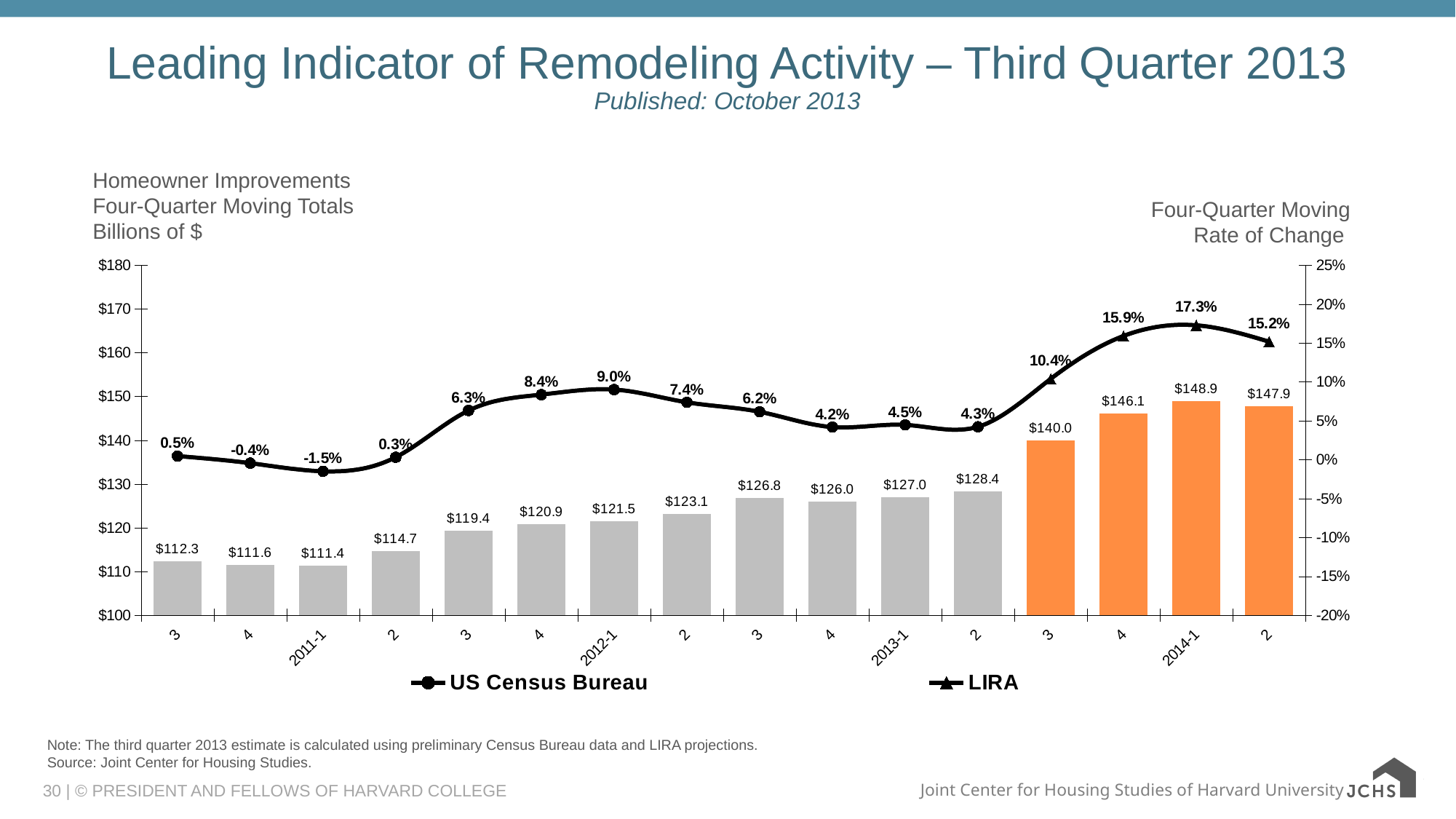
What kind of chart is this? Combined bar and line chart Do the four-quarter moving total bars generally rise or fall from left to right? Rise How many series does the legend list? 2 How many quarters are shown on the x axis? 16 Which quarter has the highest four-quarter moving total bar? 2014-1 Which quarter has the lowest four-quarter moving total bar? 2011-1 What is the lowest four-quarter moving rate of change shown on the line? -1.5% What is the highest four-quarter moving rate of change shown on the line? 17.3% What is the four-quarter moving total for 2012-1? $121.5 What is the four-quarter moving rate of change shown for 2014-1? 17.3% Which is larger, the four-quarter moving total for 2013-1 or for 2012-1? 2013-1 What is the difference between the four-quarter moving totals for 2014-1 and 2013-1? $21.9